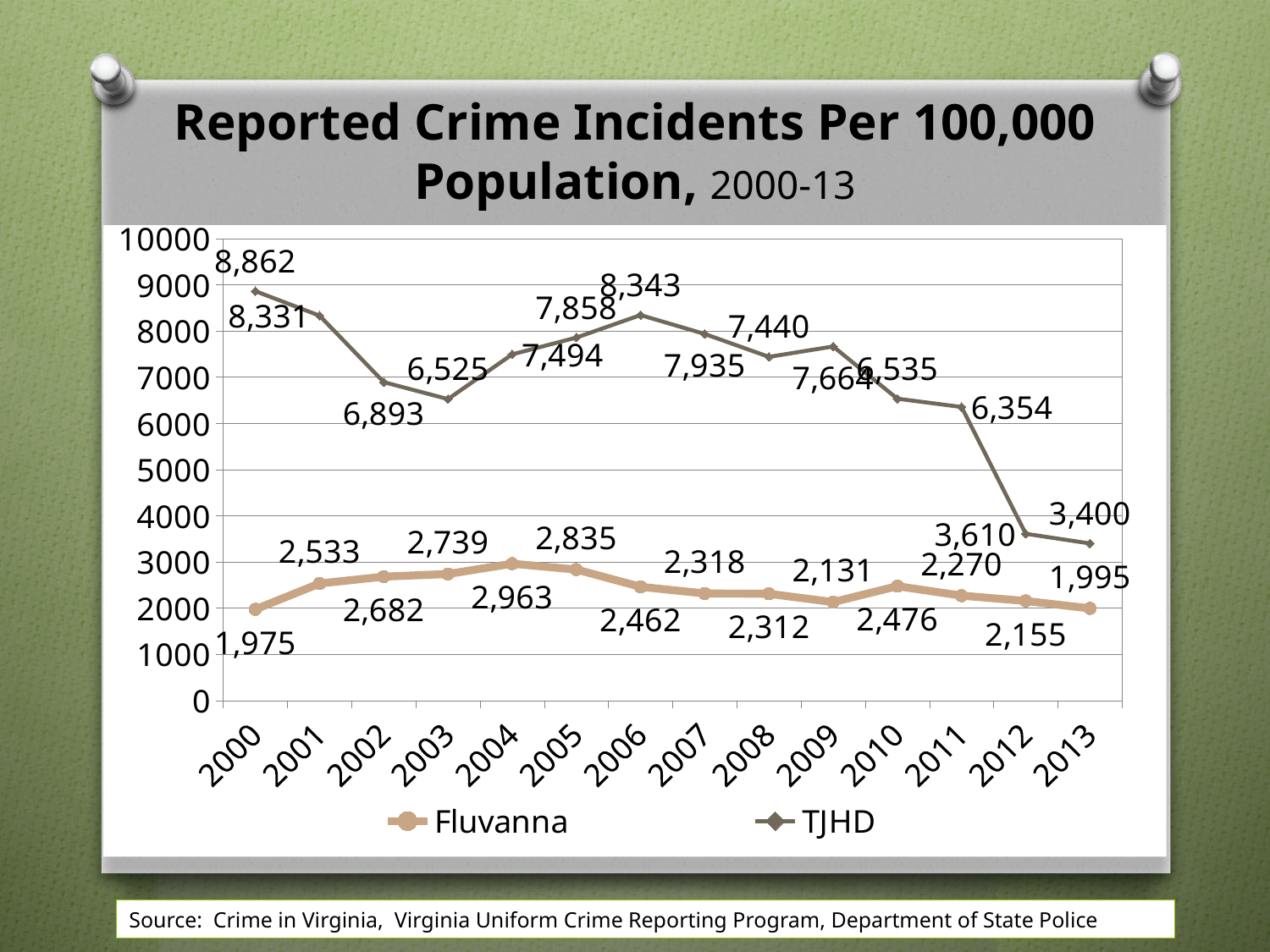
What is the TJHD value for 2000? 8,862 Does the TJHD series rise or fall from 2011 to 2013? Fall In which year is the TJHD series at its lowest? 2013 What is the TJHD value for 2013? 3,400 What is the difference between the TJHD and Fluvanna values in 2012? 1,455 In which year is the Fluvanna series at its highest? 2004 What is the Fluvanna value for 2004? 2,963 What kind of chart is shown on the slide? Line chart Which series has the larger value in 2006, Fluvanna or TJHD? TJHD How many series does the legend list? 2 Is the TJHD value for 2011 greater or less than 6000? greater How many years are plotted on the x axis? 14